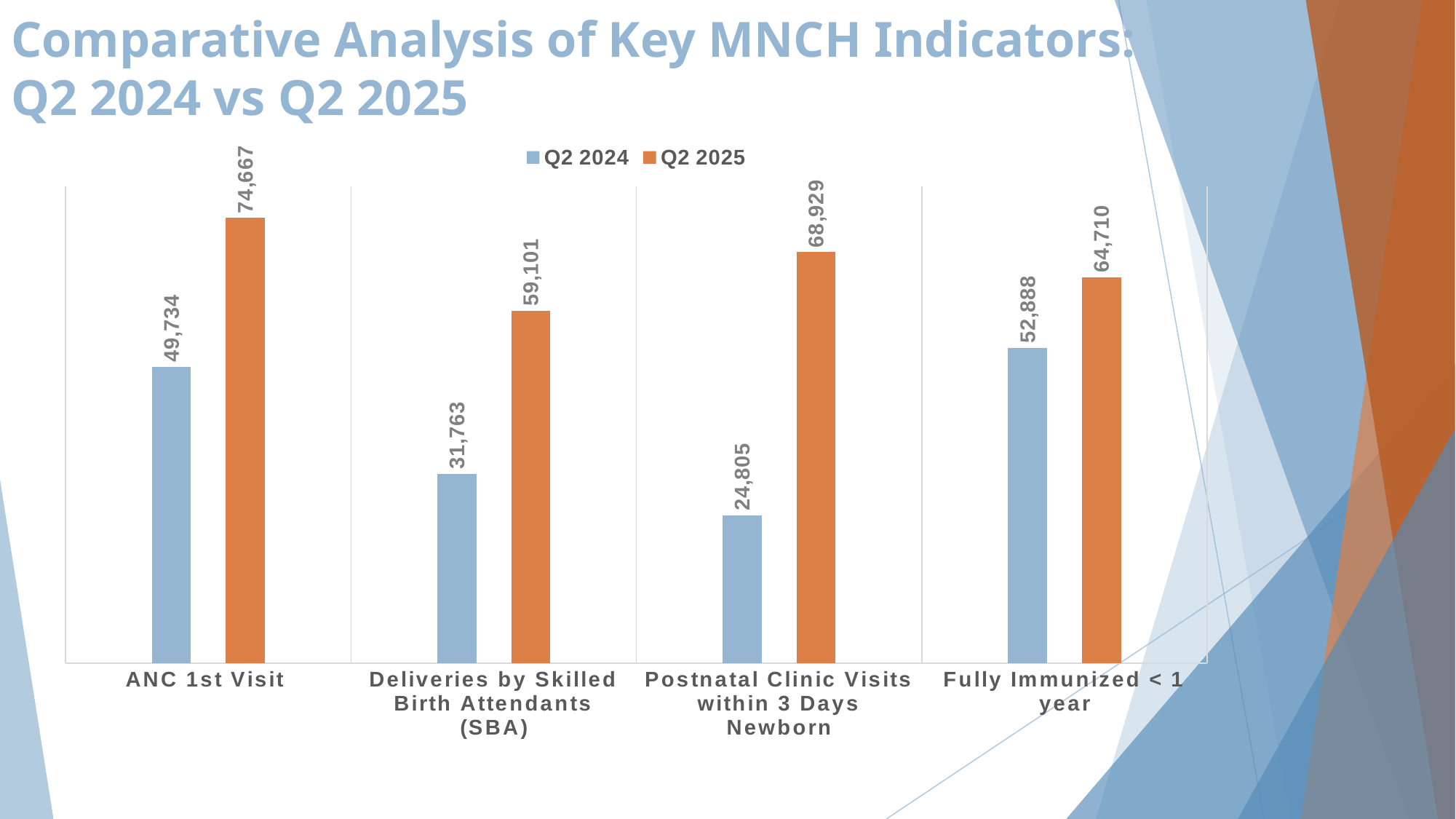
How many series does the legend list? 2 How many categories are shown on the x axis? 4 What is the Q2 2024 value for Fully Immunized < 1 year? 52,888 What is the Q2 2025 value for Deliveries by Skilled Birth Attendants (SBA)? 59,101 What is the Q2 2025 value for Postnatal Clinic Visits within 3 Days Newborn? 68,929 What is the Q2 2024 value for ANC 1st Visit? 49,734 What kind of chart is shown on the slide? Bar chart Which category has the highest Q2 2025 value? ANC 1st Visit Which is larger: the Q2 2024 value for Fully Immunized < 1 year or the Q2 2024 value for ANC 1st Visit? Fully Immunized < 1 year What is the difference between the Q2 2025 and Q2 2024 values for ANC 1st Visit? 24,933 What is the difference between the Q2 2025 and Q2 2024 values for Postnatal Clinic Visits within 3 Days Newborn? 44,124 Which category has the lowest Q2 2024 value? Postnatal Clinic Visits within 3 Days Newborn